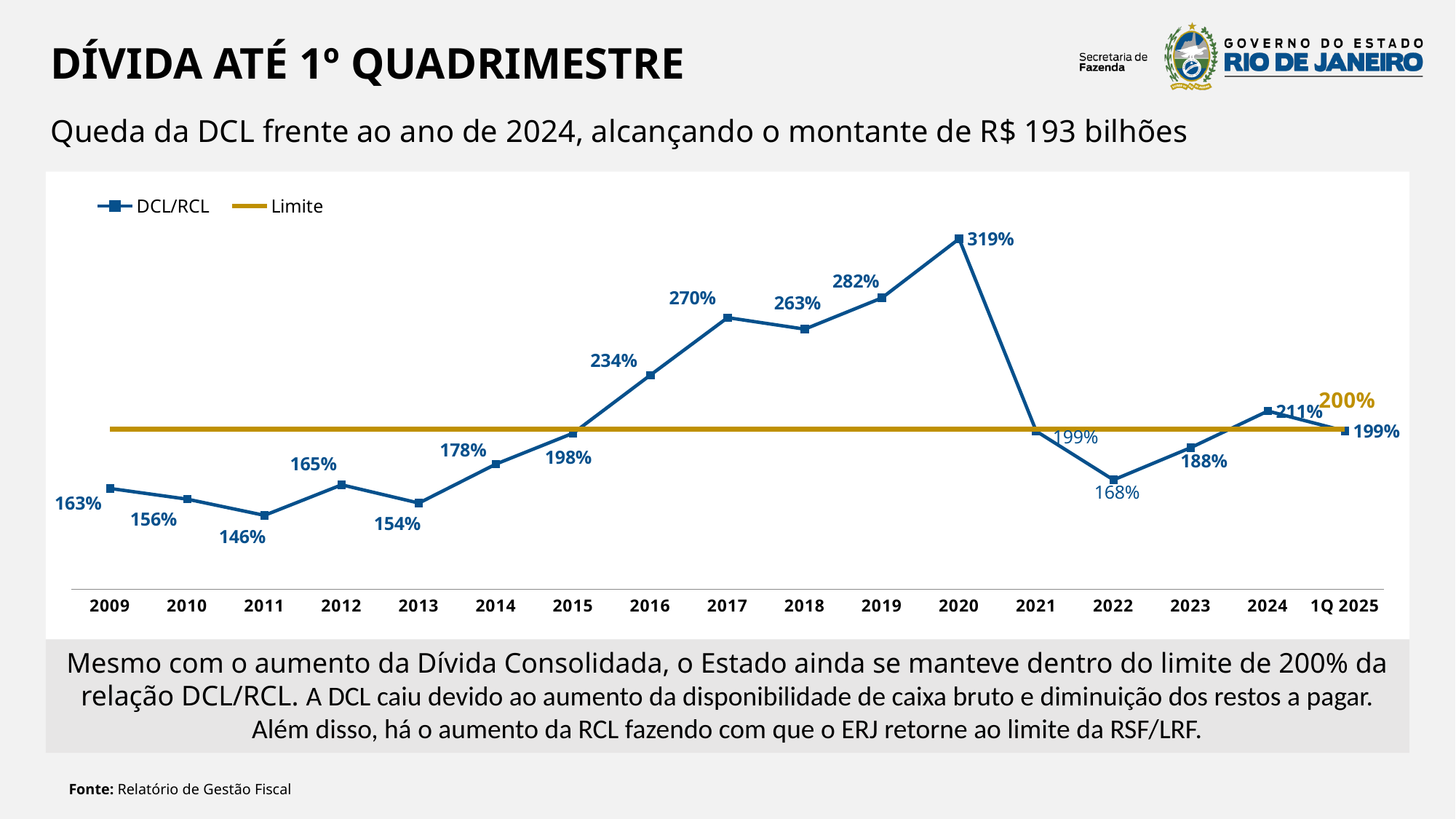
What is the DCL/RCL value for 1Q 2025? 199% What kind of chart is shown on the slide? Line chart How many data points are plotted on the DCL/RCL line? 17 Which year has the lowest DCL/RCL value? 2011 Does the DCL/RCL value rise or fall from 2020 to 2022? Fall Which year has the highest DCL/RCL value? 2020 How many series does the legend list? 2 What is the difference between the DCL/RCL values for 2020 and 2021? 120% What value does the Limite line represent? 200% Which is larger, the DCL/RCL value for 2017 or for 2018? 2017 What is the DCL/RCL value for 2020? 319% What is the DCL/RCL value for 2011? 146%